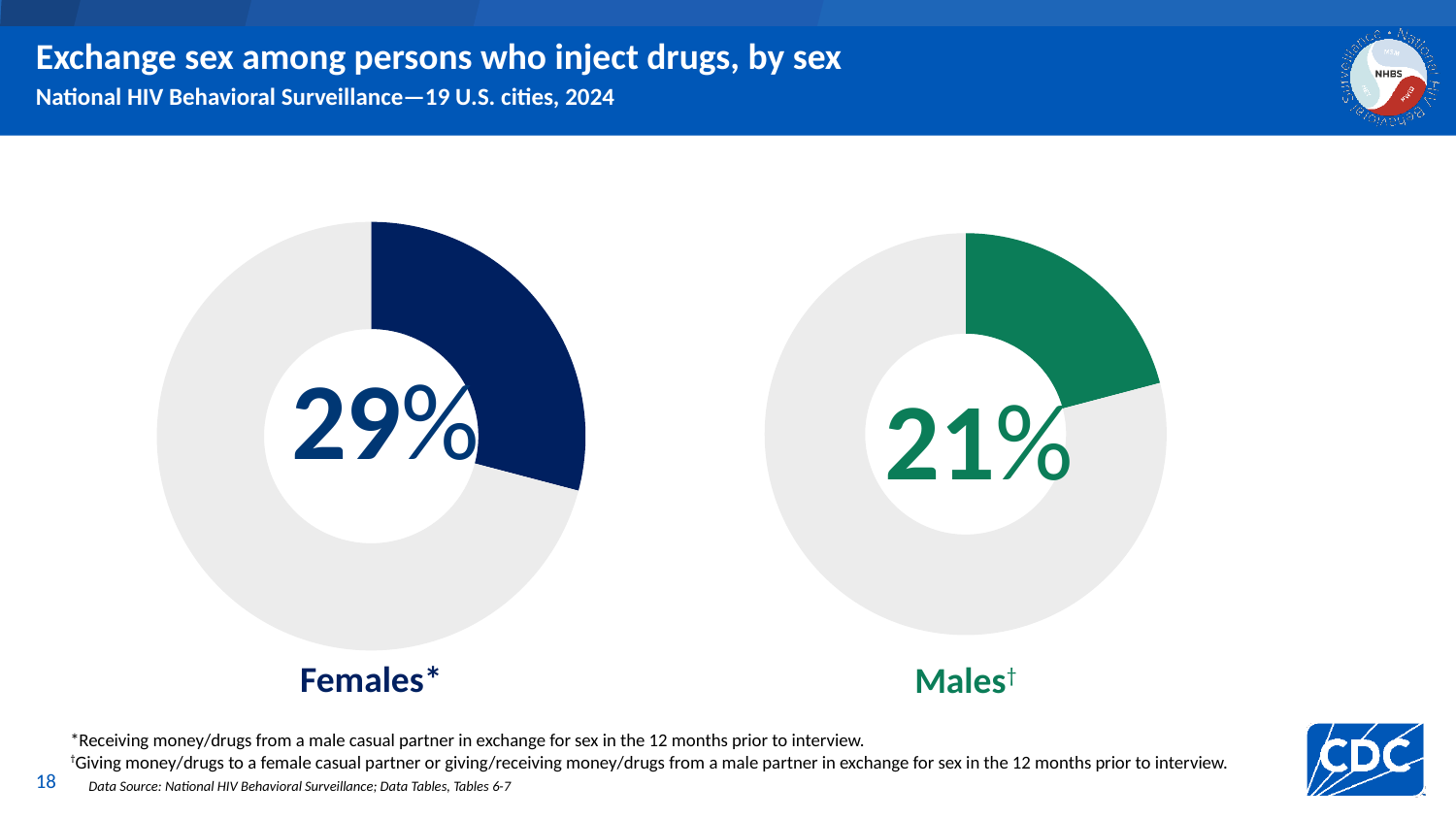
What share of the Males donut is filled in green? 21% What percentage of females who inject drugs reported exchange sex? 29% What percentage of males who inject drugs reported exchange sex? 21% What is the title of the slide's chart? Exchange sex among persons who inject drugs, by sex What is the difference in percentage points between females and males for exchange sex? 8 Which group has the higher percentage of exchange sex, females or males? Females What colour is the filled portion of the Males donut chart? Green Which group has the lowest percentage of exchange sex? Males What kind of charts are shown on the slide? Donut (pie) charts How many donut charts are shown on the slide? 2 What share of the Females donut is filled in dark blue? 29%